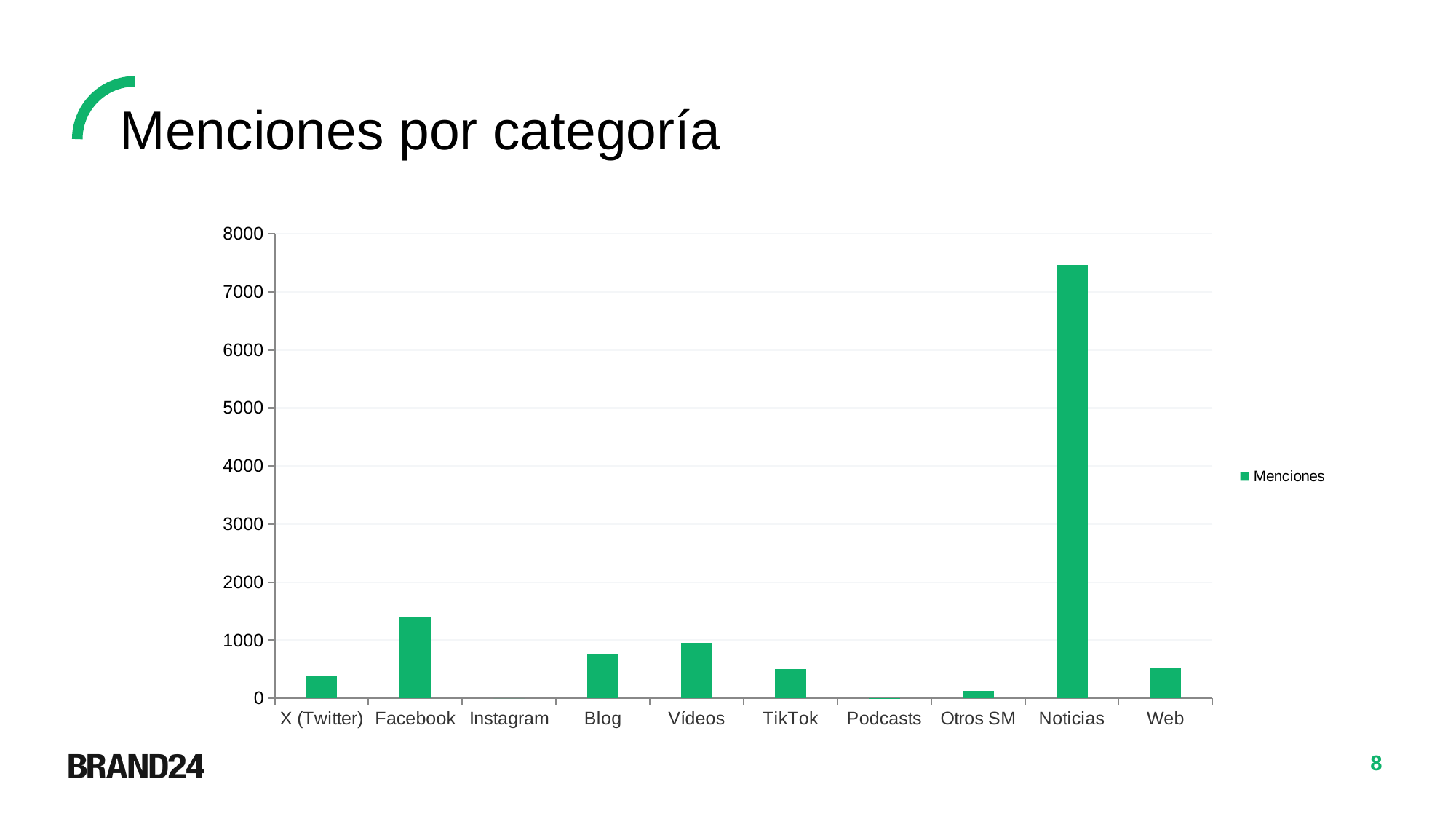
Which category has the highest number of mentions? Noticias Is the value for X (Twitter) greater or less than 1000? less What kind of chart is shown on the slide? Bar chart Which has more mentions, Facebook or Blog? Facebook Is the value for Noticias greater or less than 7000? greater Which has more mentions, Vídeos or TikTok? Vídeos Is the value for Facebook greater or less than 1000? greater How many categories are shown on the x axis of the chart? 10 How many series does the legend list? 1 What is the title of the slide containing the chart? Menciones por categoría What is the name of the series shown in the legend? Menciones